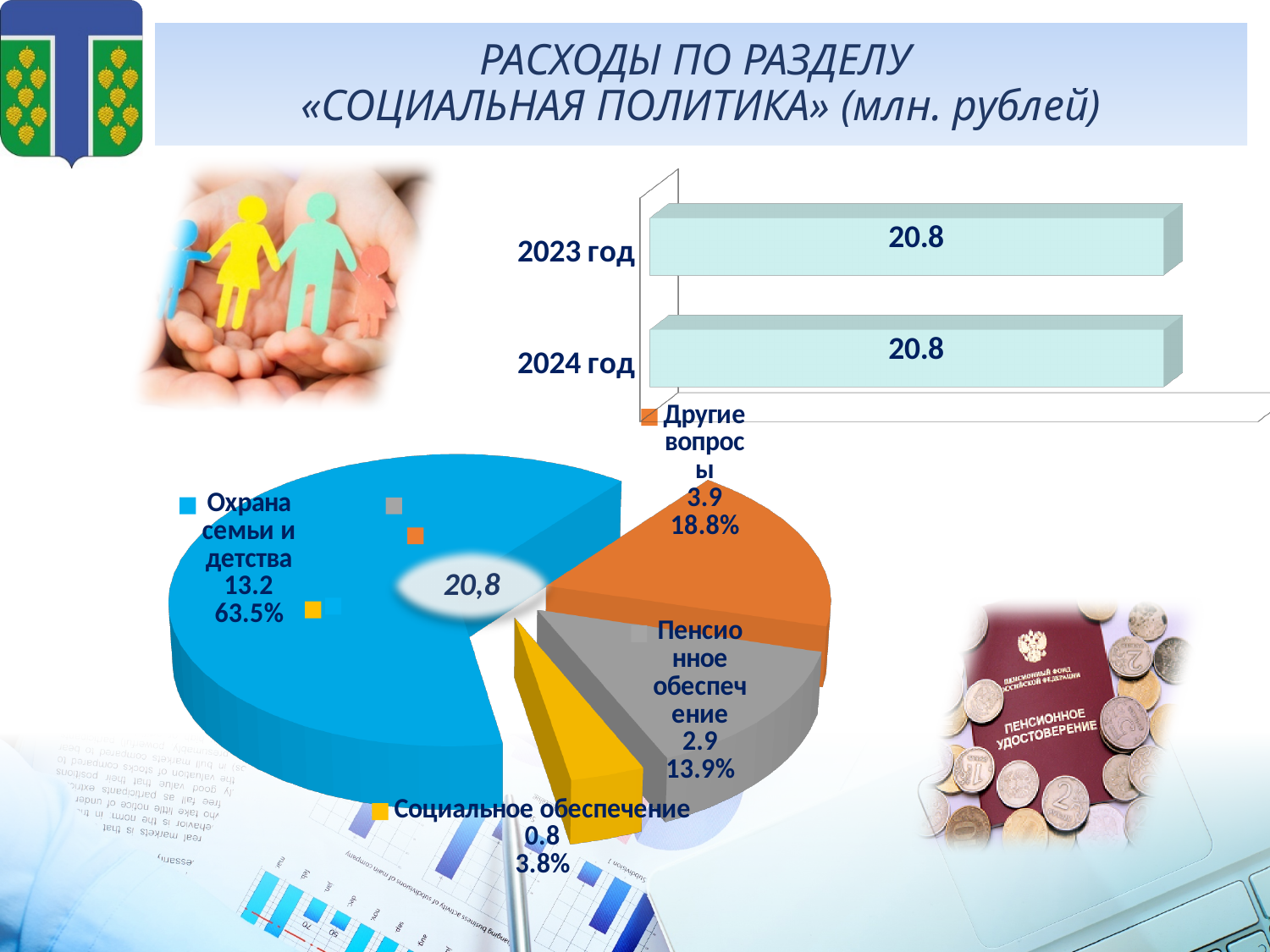
On the pie chart, how many slices are there? 4 On the bar chart at the top right, what is the value for 2024 год? 20.8 On the pie chart, what is the value for Охрана семьи и детства? 13.2 On the pie chart, which category has the smallest slice? Социальное обеспечение On the pie chart, which is larger: Другие вопросы or Пенсионное обеспечение? Другие вопросы On the bar chart at the top right, how many categories are shown? 2 On the pie chart, what share does Пенсионное обеспечение have? 13.9% On the pie chart, which category has the largest slice? Охрана семьи и детства On the bar chart at the top right, what is the value for 2023 год? 20.8 On the bar chart at the top right, what is the difference between the values for 2023 год and 2024 год? 0 What kind of chart is the one at the top right showing 2023 год and 2024 год? bar chart On the pie chart, what is the difference between the values for Охрана семьи и детства and Другие вопросы? 9.3